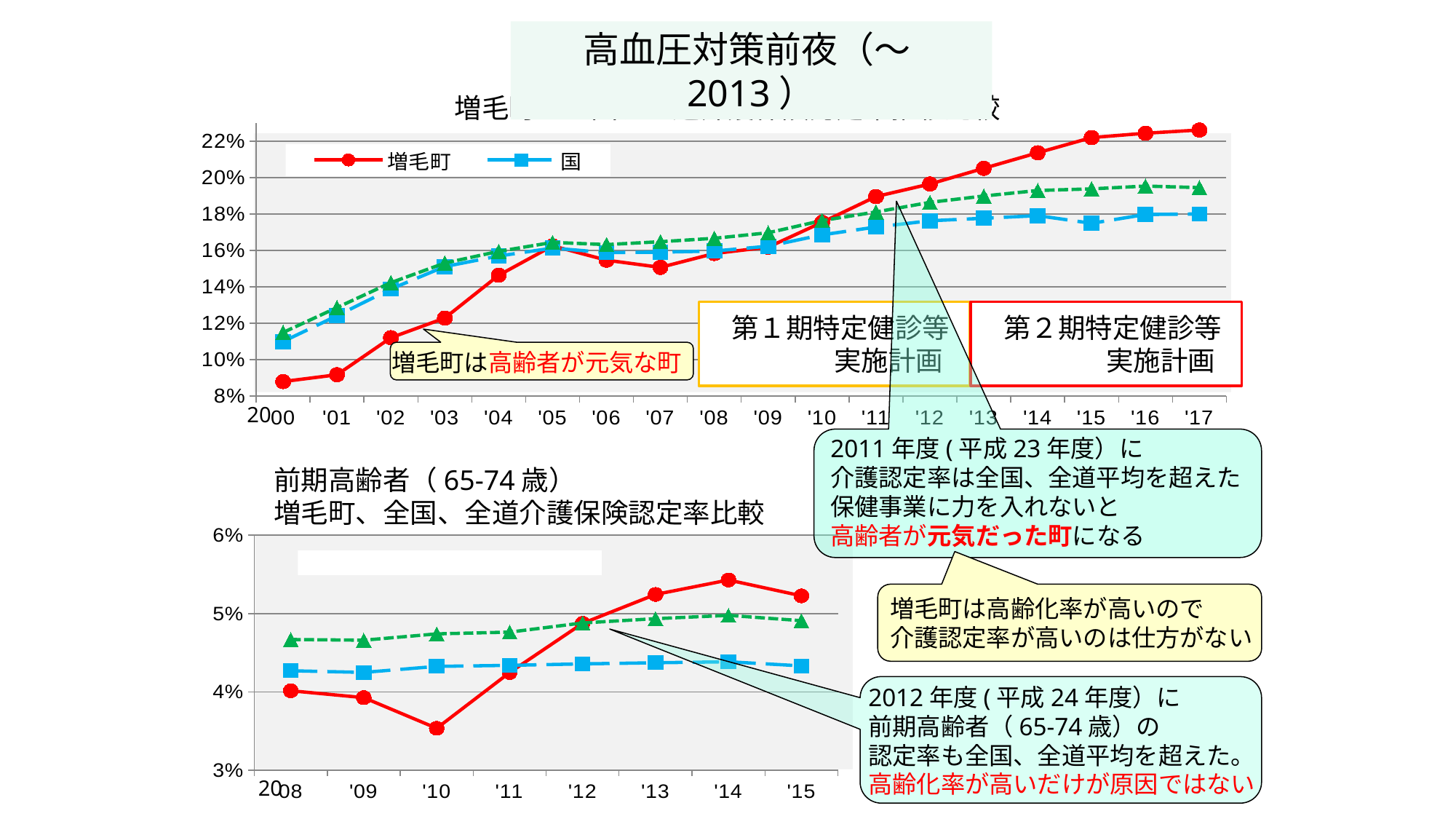
In the bottom chart (前期高齢者（65-74歳）), in which year is the red line at its highest? '14 In the top chart, is the value for 増毛町 in 2000 greater or less than 10%? less In the top chart, does the 国 series rise or fall from 2000 to '17? rises In the top chart, which series is higher in '03, 増毛町 or 国? 国 How many series does the legend of the top chart list? 2 In the top chart, how many years are shown along the x axis? 18 In the top chart, in which year is the 増毛町 series at its lowest? 2000 In the top chart, which series is higher in '17, 増毛町 or 国? 増毛町 What kind of chart is the top chart on the slide? line chart In the top chart, is the value for 増毛町 in '17 greater or less than 22%? greater In the bottom chart (前期高齢者（65-74歳）), how many years are shown along the x axis? 8 In the bottom chart (前期高齢者（65-74歳）), is the value of the red line in '10 greater or less than 4%? less